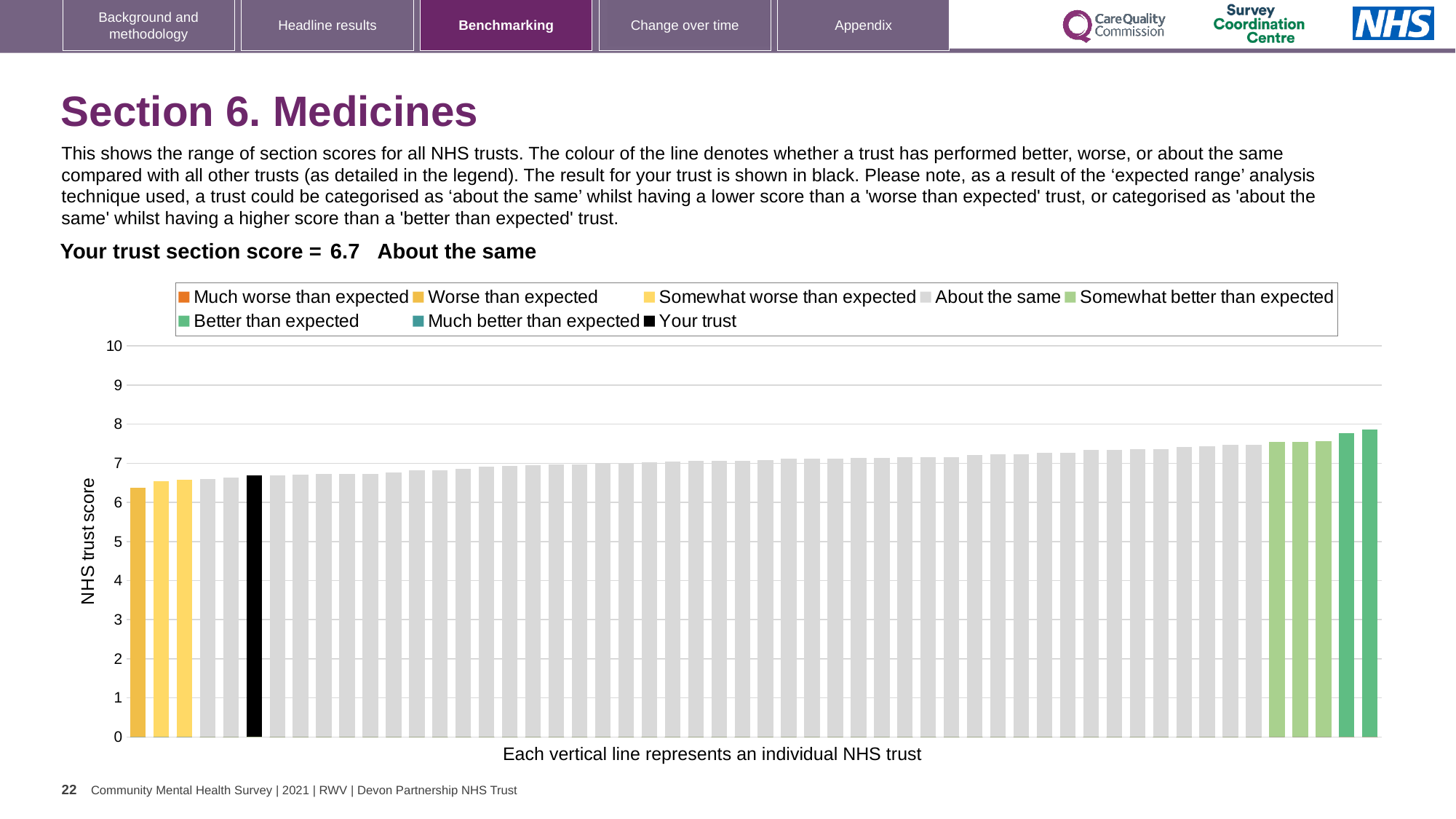
Is the value of the shortest bar greater or less than 7? less Which performance category is the trust's section score assigned to? About the same What is the trust section score shown for Section 6. Medicines? 6.7 What colour is the bar representing your trust? black What is the highest value shown on the y axis? 10 Is the value of the black 'Your trust' bar greater or less than 6? greater How many bars are coloured yellow (worse than expected categories)? 3 Is the value of the tallest bar greater or less than 8? less How many entries does the chart legend list? 8 What kind of chart is shown on the slide? bar chart Do the bar values rise or fall from left to right along the x axis? rise